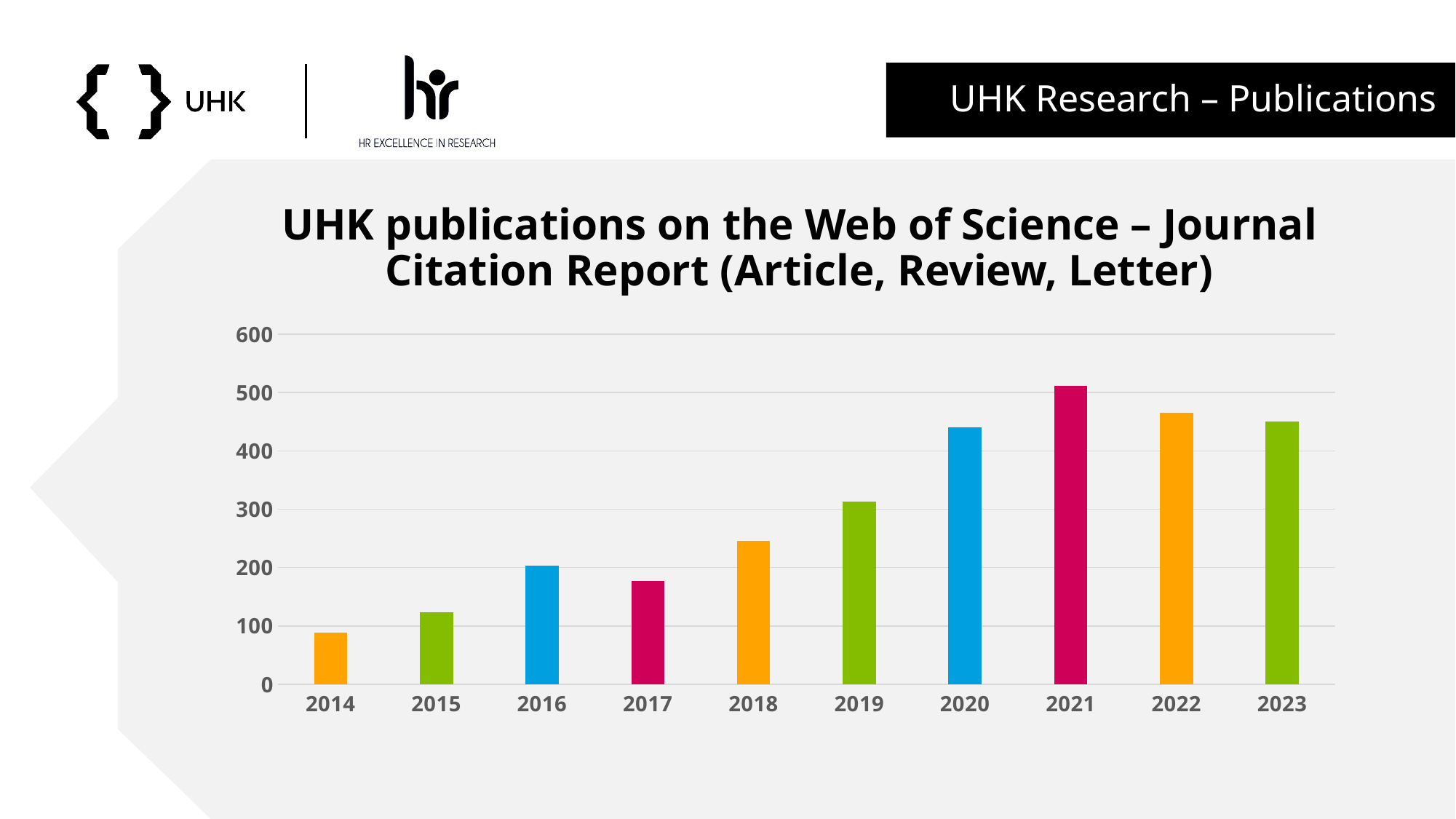
Which year has the highest number of UHK publications in the chart? 2021 Which year has the lowest number of UHK publications in the chart? 2014 How many years are shown on the x axis of the chart? 10 Is the value for 2014 greater or less than 100? less Is the value for 2023 greater or less than 400? greater What is the title of the chart? UHK publications on the Web of Science – Journal Citation Report (Article, Review, Letter) What kind of chart is shown on the slide? bar chart Which year has the larger value, 2016 or 2017? 2016 Is the value for 2017 greater or less than 200? less Do the values generally rise or fall from 2014 to 2021? rise